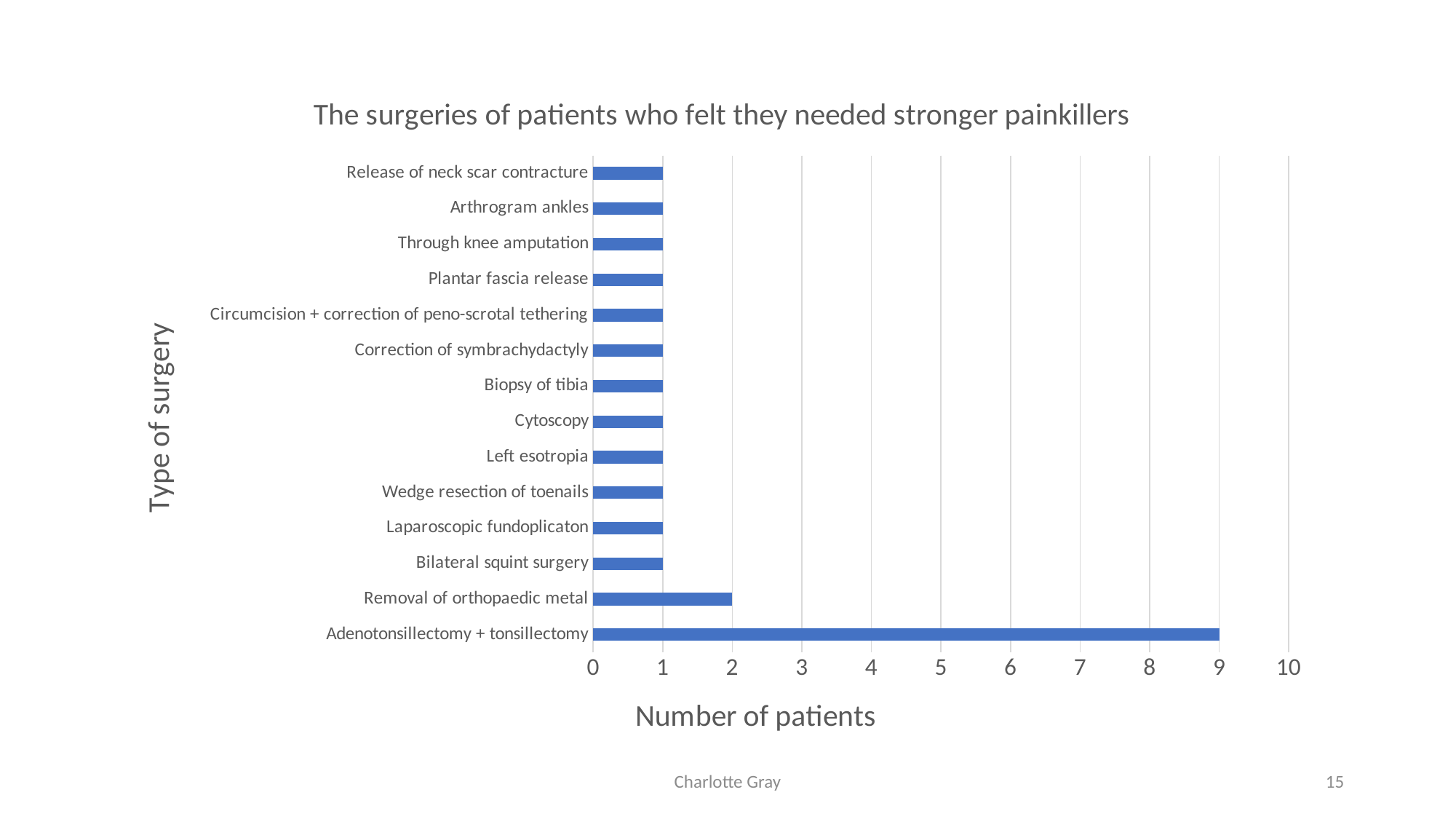
How many patients are shown for Removal of orthopaedic metal? 2 Is the value for Adenotonsillectomy + tonsillectomy greater or less than 5? greater What kind of chart is shown on the slide? bar chart How many types of surgery are listed on the chart? 14 What is the label of the horizontal axis? Number of patients What is the title of the chart? The surgeries of patients who felt they needed stronger painkillers What is the difference in number of patients between Adenotonsillectomy + tonsillectomy and Removal of orthopaedic metal? 7 How many patients are shown for Biopsy of tibia? 1 How many types of surgery have exactly 1 patient? 12 How many patients are shown for Adenotonsillectomy + tonsillectomy? 9 Which type of surgery has the highest number of patients? Adenotonsillectomy + tonsillectomy Which has more patients, Removal of orthopaedic metal or Cytoscopy? Removal of orthopaedic metal